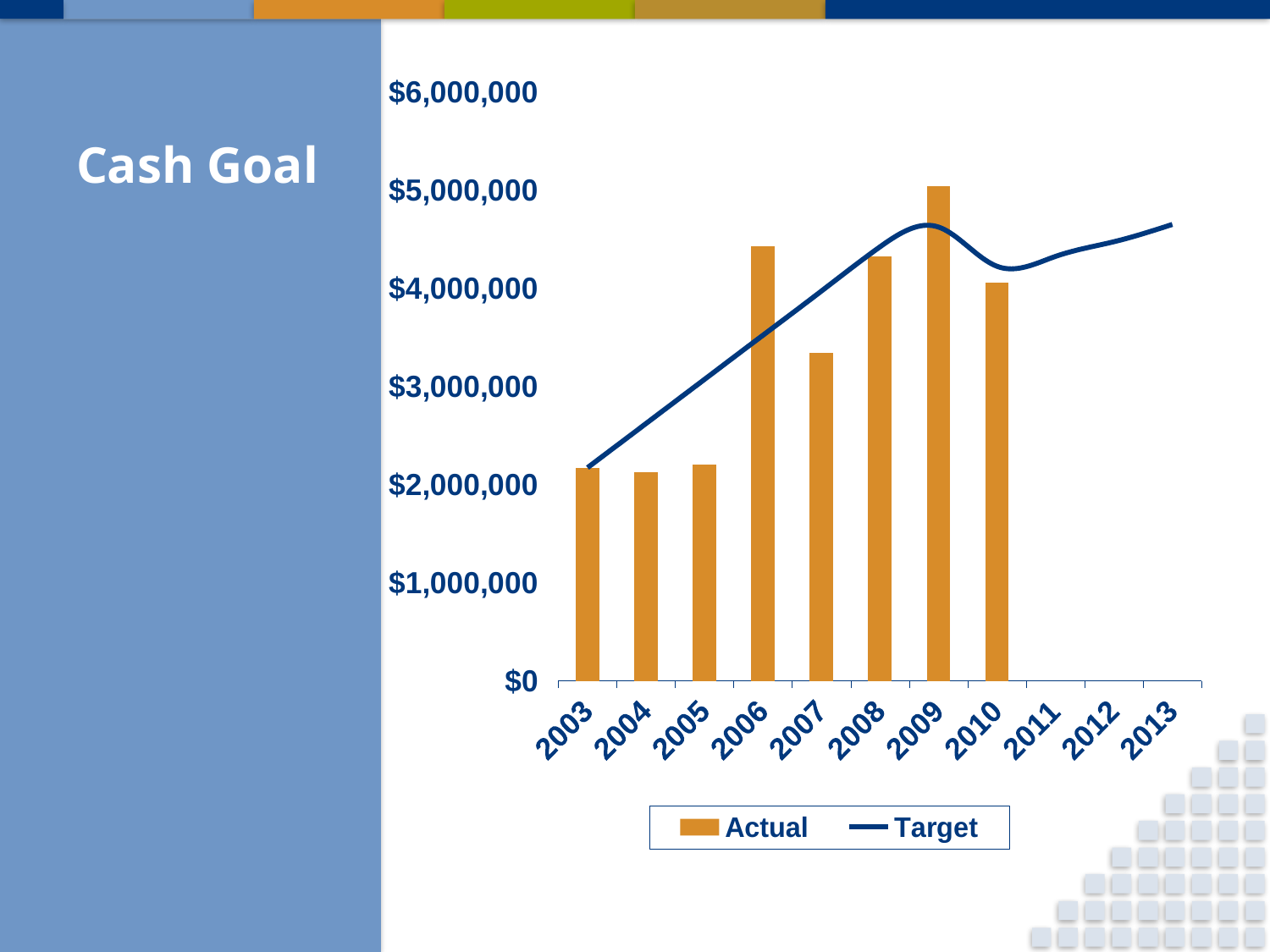
Is the Actual value for 2009 greater or less than $4,000,000? greater How many years have an Actual bar plotted? 8 What are the two series named in the legend? Actual and Target What kind of chart is used to plot the Actual series? bar chart Does the Target line generally rise or fall from 2003 to 2009? rise Is the Actual value for 2004 greater or less than $3,000,000? less Which year has the larger Actual bar, 2006 or 2007? 2006 Is the Actual value for 2007 greater or less than $4,000,000? less How many series does the legend list? 2 Which year has the highest Actual bar? 2009 In 2007, is the Actual bar above or below the Target line? below How many years are labelled on the x axis? 11